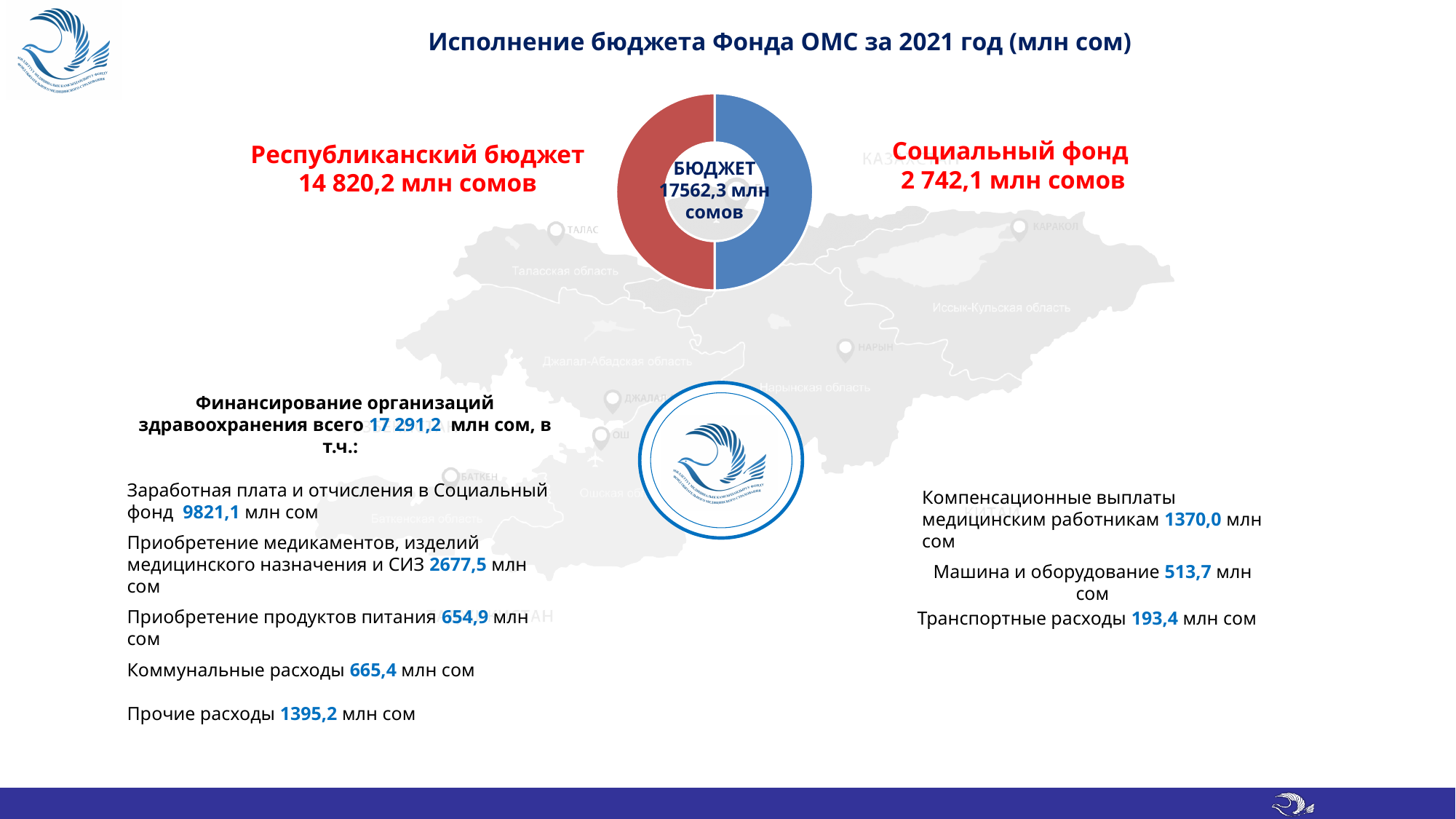
What is the difference between Республиканский бюджет and Социальный фонд? 12 078,1 млн сомов What kind of chart is shown on the slide? Donut (pie) chart How many segments does the donut chart have? 2 Which of the two budget sources has the largest value? Республиканский бюджет Which source is larger, Республиканский бюджет or Социальный фонд? Республиканский бюджет Which of the two budget sources has the smallest value? Социальный фонд What colour is the segment of the donut chart next to the Республиканский бюджет label? Red What value is shown for Социальный фонд? 2 742,1 млн сомов What is the title of the slide containing the donut chart? Исполнение бюджета Фонда ОМС за 2021 год (млн сом) What total budget value is printed in the centre of the donut chart? 17562,3 млн сомов What value is shown for Республиканский бюджет? 14 820,2 млн сомов